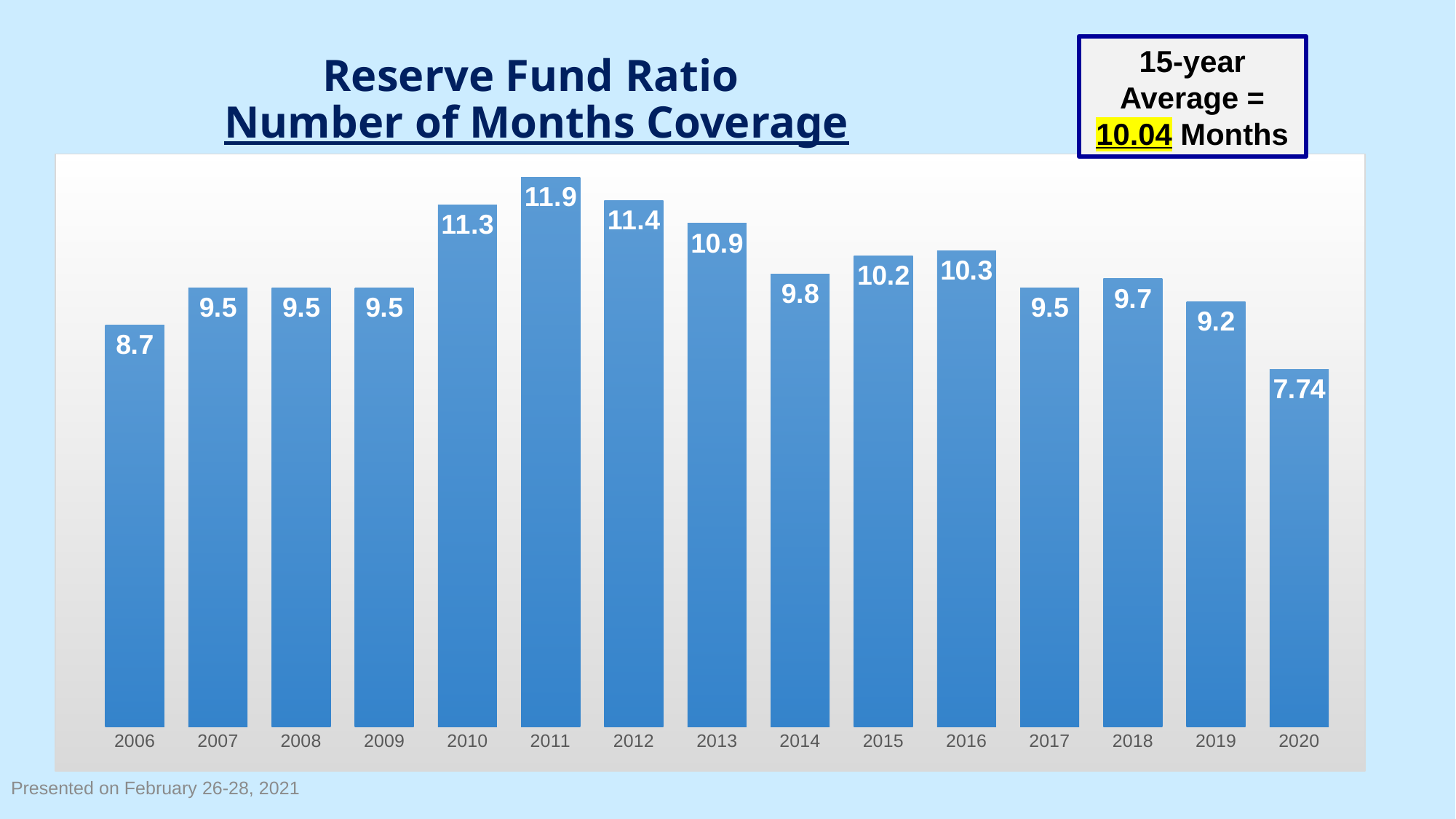
What is the number of months coverage for 2020? 7.74 Which year has the highest number of months coverage? 2011 What kind of chart is shown on the slide? Bar chart What is the number of months coverage for 2006? 8.7 What is the difference between the 2011 value and the 2020 value? 4.16 What is the number of months coverage for 2011? 11.9 Which year has a larger value, 2013 or 2014? 2013 Which year has a larger value, 2018 or 2019? 2018 Which year has the lowest number of months coverage? 2020 What is the 15-year average stated on the slide? 10.04 Months What is the difference between the 2010 value and the 2006 value? 2.6 How many years are shown on the chart? 15